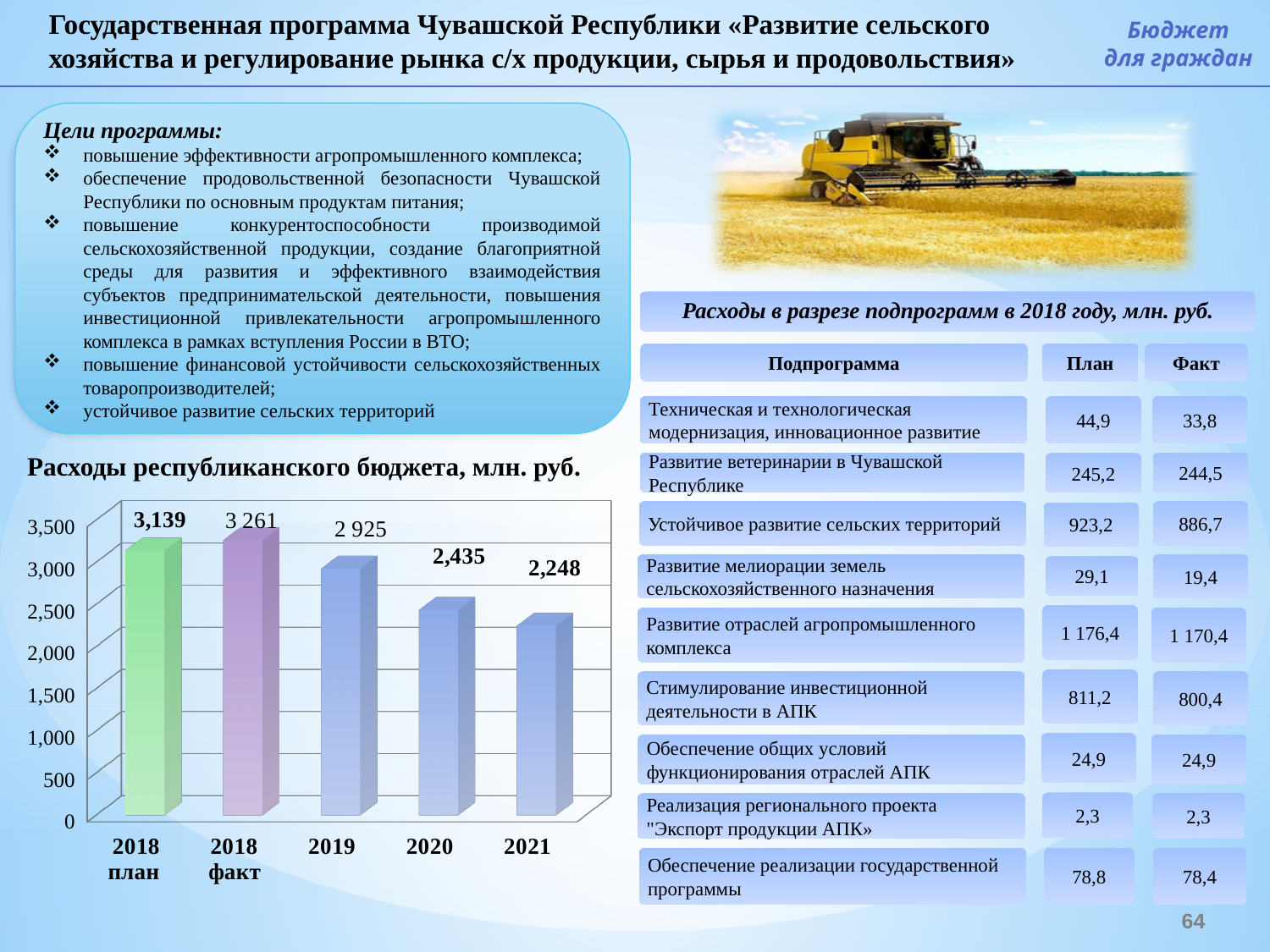
In the chart 'Расходы республиканского бюджета, млн. руб.', which is larger: the value for 2019 or the value for 2020? 2019 Which category has the highest value in the chart 'Расходы республиканского бюджета, млн. руб.'? 2018 факт What kind of chart is 'Расходы республиканского бюджета, млн. руб.'? bar chart What is the value for 2021 in the chart 'Расходы республиканского бюджета, млн. руб.'? 2,248 In the chart 'Расходы республиканского бюджета, млн. руб.', is the value for 2021 greater or less than 2,500? less How many bars are shown in the chart 'Расходы республиканского бюджета, млн. руб.'? 5 In the chart 'Расходы республиканского бюджета, млн. руб.', do the values rise or fall from 2019 to 2021? fall What is the value for 2018 план in the chart 'Расходы республиканского бюджета, млн. руб.'? 3,139 Which category has the lowest value in the chart 'Расходы республиканского бюджета, млн. руб.'? 2021 In the chart 'Расходы республиканского бюджета, млн. руб.', what is the difference between the 2018 факт and 2018 план values? 122 What is the value for 2018 факт in the chart 'Расходы республиканского бюджета, млн. руб.'? 3 261 In the chart 'Расходы республиканского бюджета, млн. руб.', what is the difference between the 2019 and 2020 values? 490